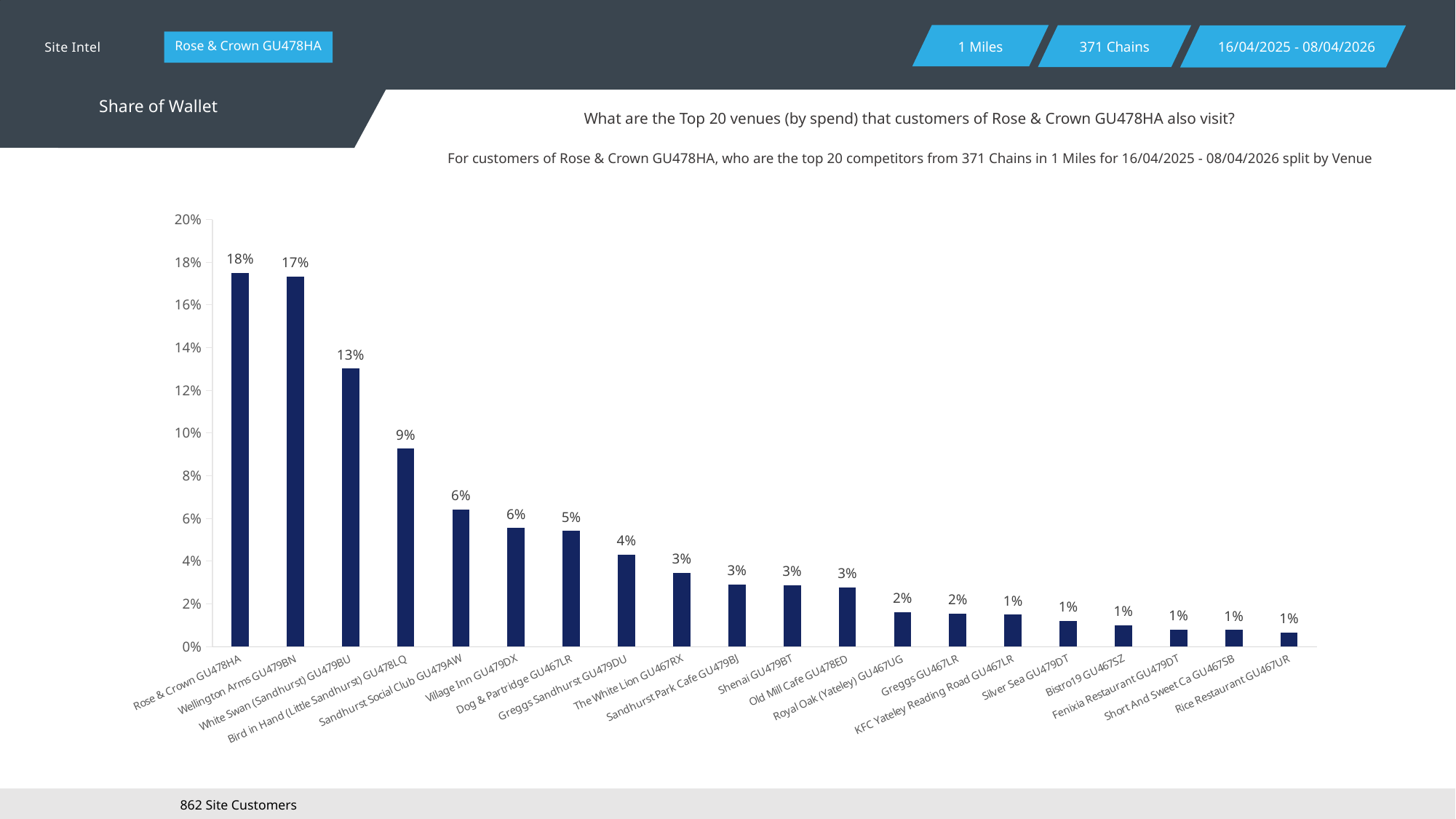
How many venues are shown on the chart? 20 Which venue has the highest value? Rose & Crown GU478HA What is the difference between the values for Rose & Crown GU478HA and White Swan (Sandhurst) GU479BU? 5% What kind of chart is shown on the slide? bar chart Which is larger, the value for Wellington Arms GU479BN or the value for Bird in Hand (Little Sandhurst) GU478LQ? Wellington Arms GU479BN What is the value for Greggs Sandhurst GU479DU? 4% Is the value for Sandhurst Social Club GU479AW greater or less than 10%? less What is the value for Bird in Hand (Little Sandhurst) GU478LQ? 9% What is the value for Rose & Crown GU478HA? 18% Do the values rise or fall from left to right along the x axis? fall What is the value for Dog & Partridge GU467LR? 5% What is the value for White Swan (Sandhurst) GU479BU? 13%